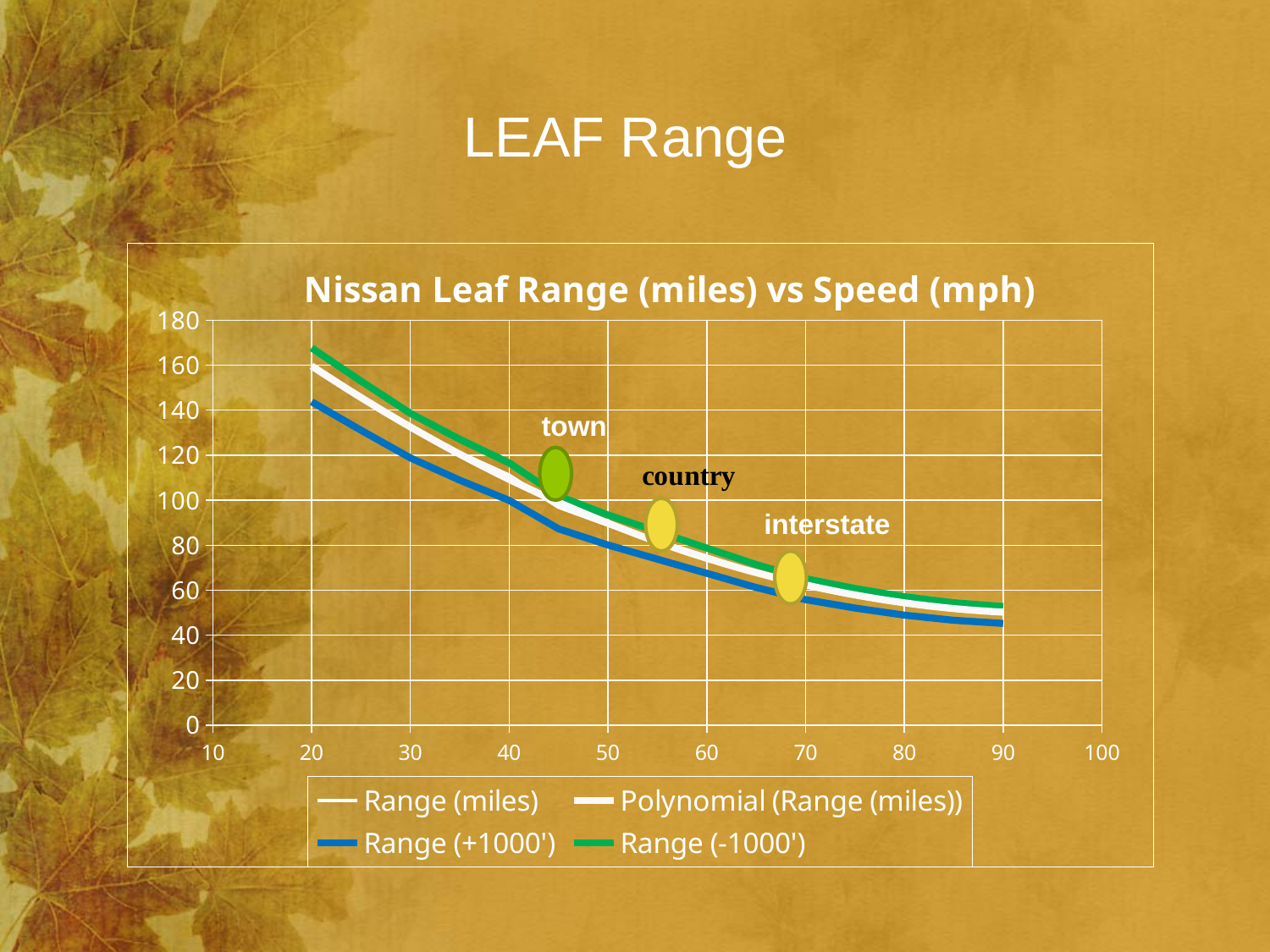
Is the value of Range (-1000') at 40 mph greater or less than 100? greater Is the value of Range (-1000') at 20 mph greater or less than 160? greater What is the title of the chart? Nissan Leaf Range (miles) vs Speed (mph) Is the value of Range (+1000') at 60 mph greater or less than 80? less Which series has the lowest values across the speed range? Range (+1000') What kind of chart is shown on the slide? line chart How many series does the chart legend list? 4 At 20 mph, which series has the higher value, Range (-1000') or Range (+1000')? Range (-1000') What three driving-condition labels are annotated on the chart? town, country, interstate Do the range values rise or fall as speed increases along the x axis? fall